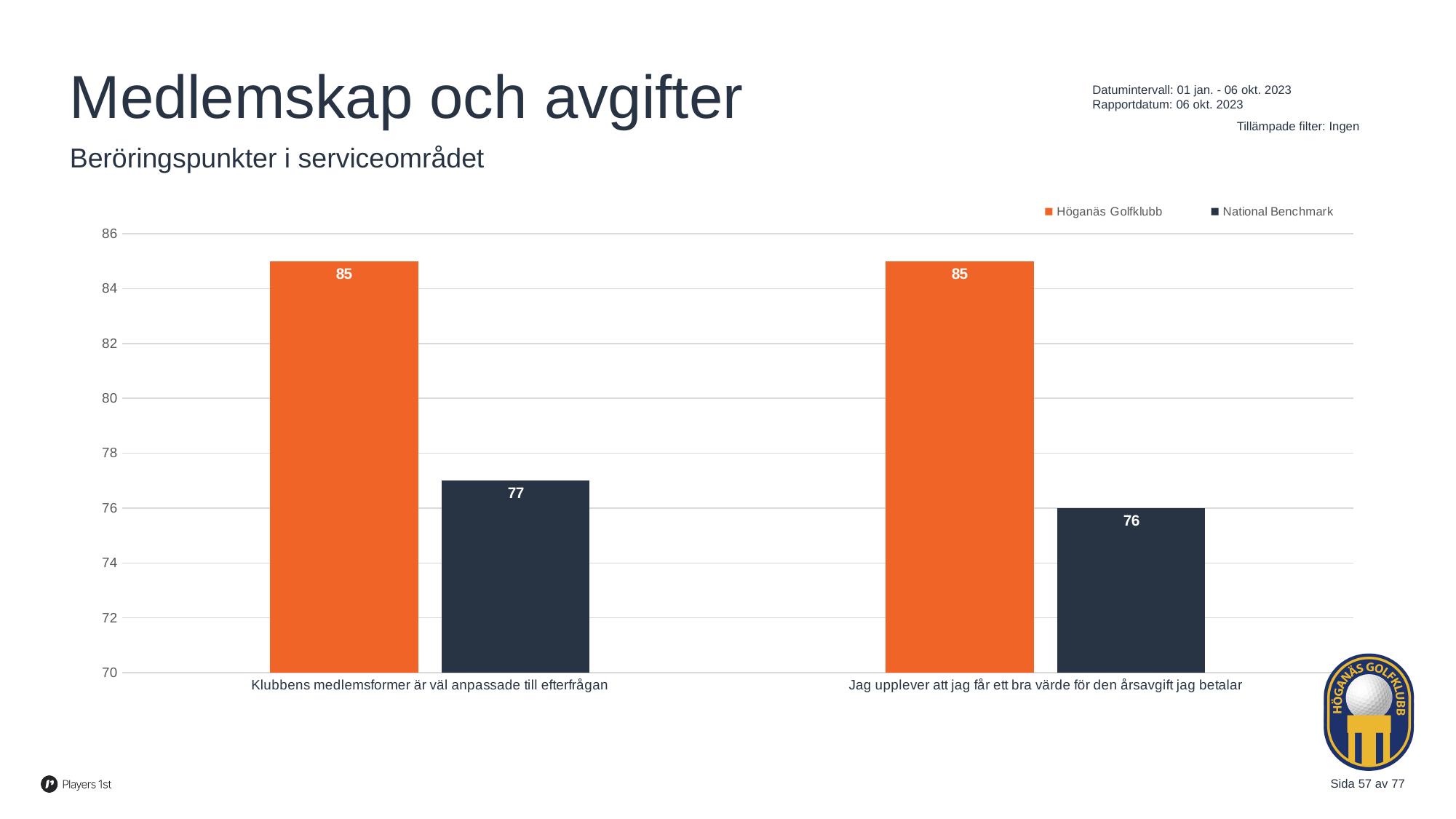
How many categories are shown on the x axis? 2 Which category has the lowest National Benchmark value? Jag upplever att jag får ett bra värde för den årsavgift jag betalar How many series does the legend list? 2 What is the National Benchmark value for "Klubbens medlemsformer är väl anpassade till efterfrågan"? 77 What is the value for Höganäs Golfklubb for "Jag upplever att jag får ett bra värde för den årsavgift jag betalar"? 85 What is the value for Höganäs Golfklubb for "Klubbens medlemsformer är väl anpassade till efterfrågan"? 85 Which series has the higher value for "Jag upplever att jag får ett bra värde för den årsavgift jag betalar"? Höganäs Golfklubb Is the National Benchmark value for "Klubbens medlemsformer är väl anpassade till efterfrågan" greater or less than 80? less What is the difference between Höganäs Golfklubb and National Benchmark for "Klubbens medlemsformer är väl anpassade till efterfrågan"? 8 What is the National Benchmark value for "Jag upplever att jag får ett bra värde för den årsavgift jag betalar"? 76 What is the difference between Höganäs Golfklubb and National Benchmark for "Jag upplever att jag får ett bra värde för den årsavgift jag betalar"? 9 What kind of chart is shown on the slide? bar chart